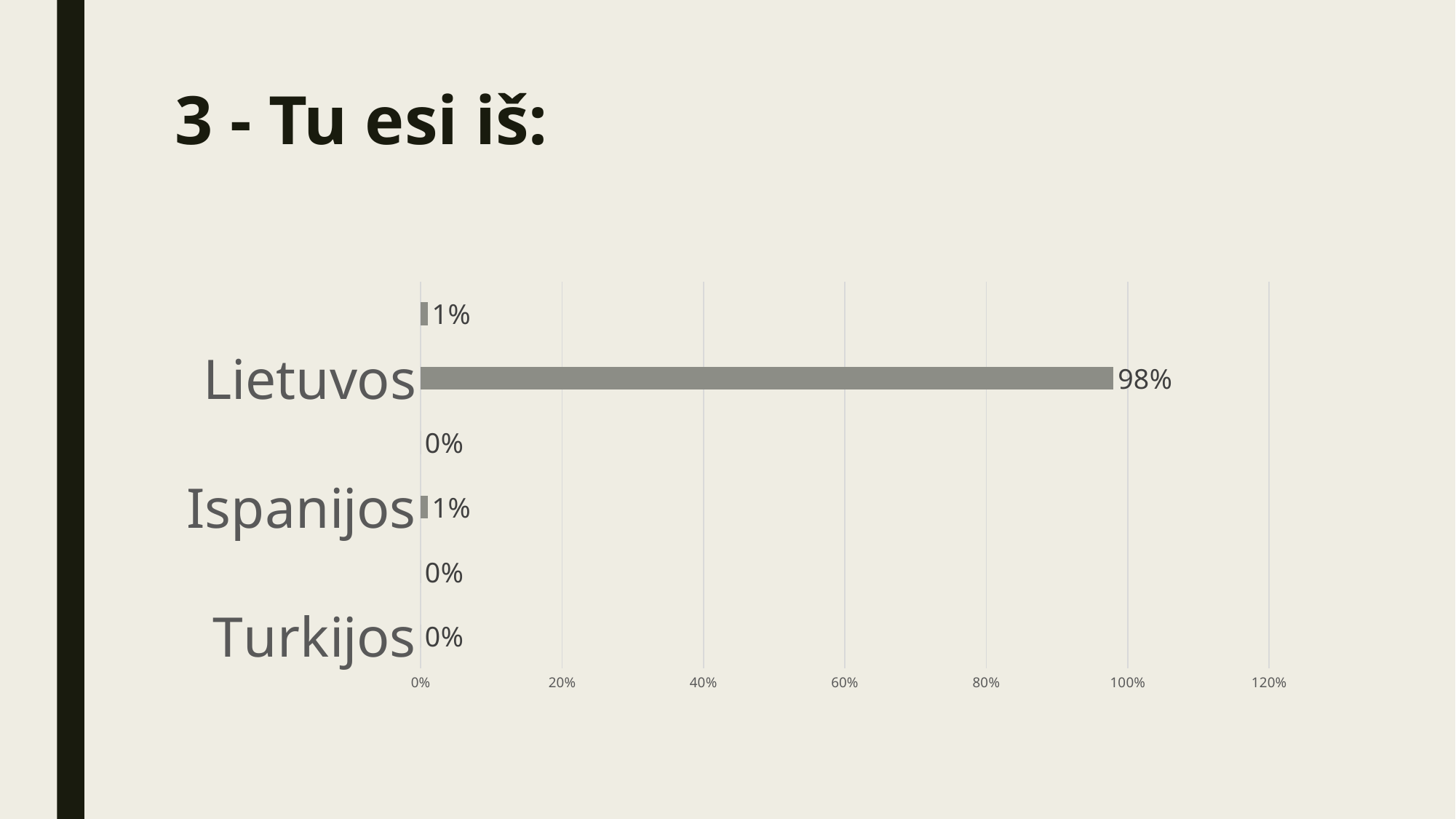
What is the highest tick label shown on the horizontal axis? 120% Which category has the highest value? Lietuvos What is the difference between the values for Lietuvos and Turkijos? 98% What is the title of the slide? 3 - Tu esi iš: What is the value for Turkijos? 0% What is the difference between the values for Lietuvos and Ispanijos? 97% What is the value for Lietuvos? 98% What kind of chart is shown on the slide? bar chart Is the value for Lietuvos greater or less than 80%? greater Which is larger, the value for Lietuvos or the value for Ispanijos? Lietuvos Is the value for Ispanijos greater or less than 20%? less What is the value for Ispanijos? 1%